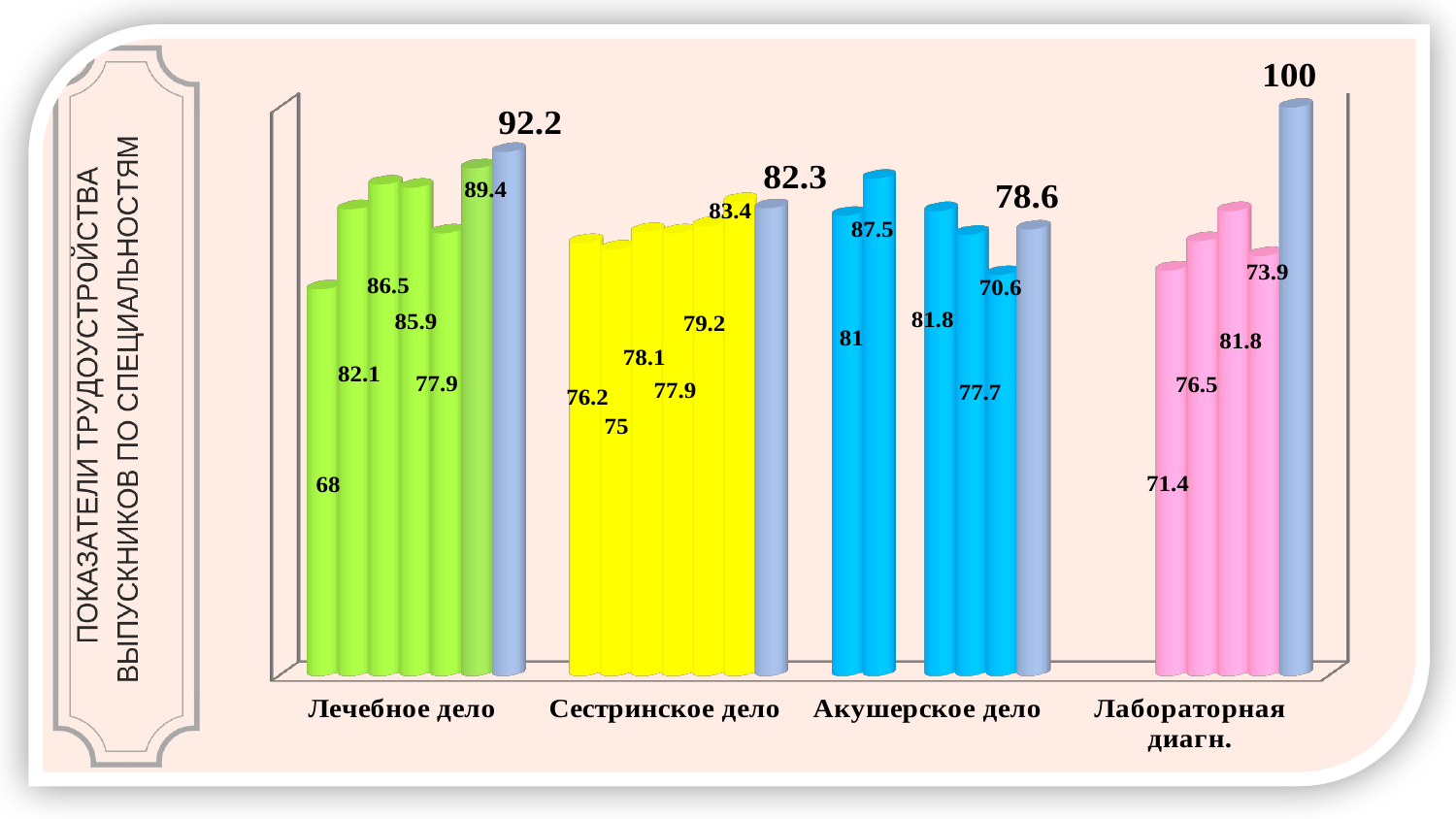
What is the title of the chart? ПОКАЗАТЕЛИ ТРУДОУСТРОЙСТВА ВЫПУСКНИКОВ ПО СПЕЦИАЛЬНОСТЯМ What is the lowest labelled value among the bars for Лечебное дело? 68 What is the highest labelled value among the bars for Акушерское дело? 87.5 What kind of chart is shown on the slide? bar chart How many specialty categories are shown along the x axis? 4 What is the value of the last (blue) bar for Лечебное дело? 92.2 Which is larger: the last (blue) bar for Сестринское дело or for Акушерское дело? Сестринское дело What is the value of the last (blue) bar for Сестринское дело? 82.3 Which category has the lowest value for its last (blue) bar? Акушерское дело What is the difference between the last (blue) bar values of Лабораторная диагн. and Лечебное дело? 7.8 What is the value of the last (blue) bar for Лабораторная диагн.? 100 Which category has the highest value for its last (blue) bar? Лабораторная диагн.